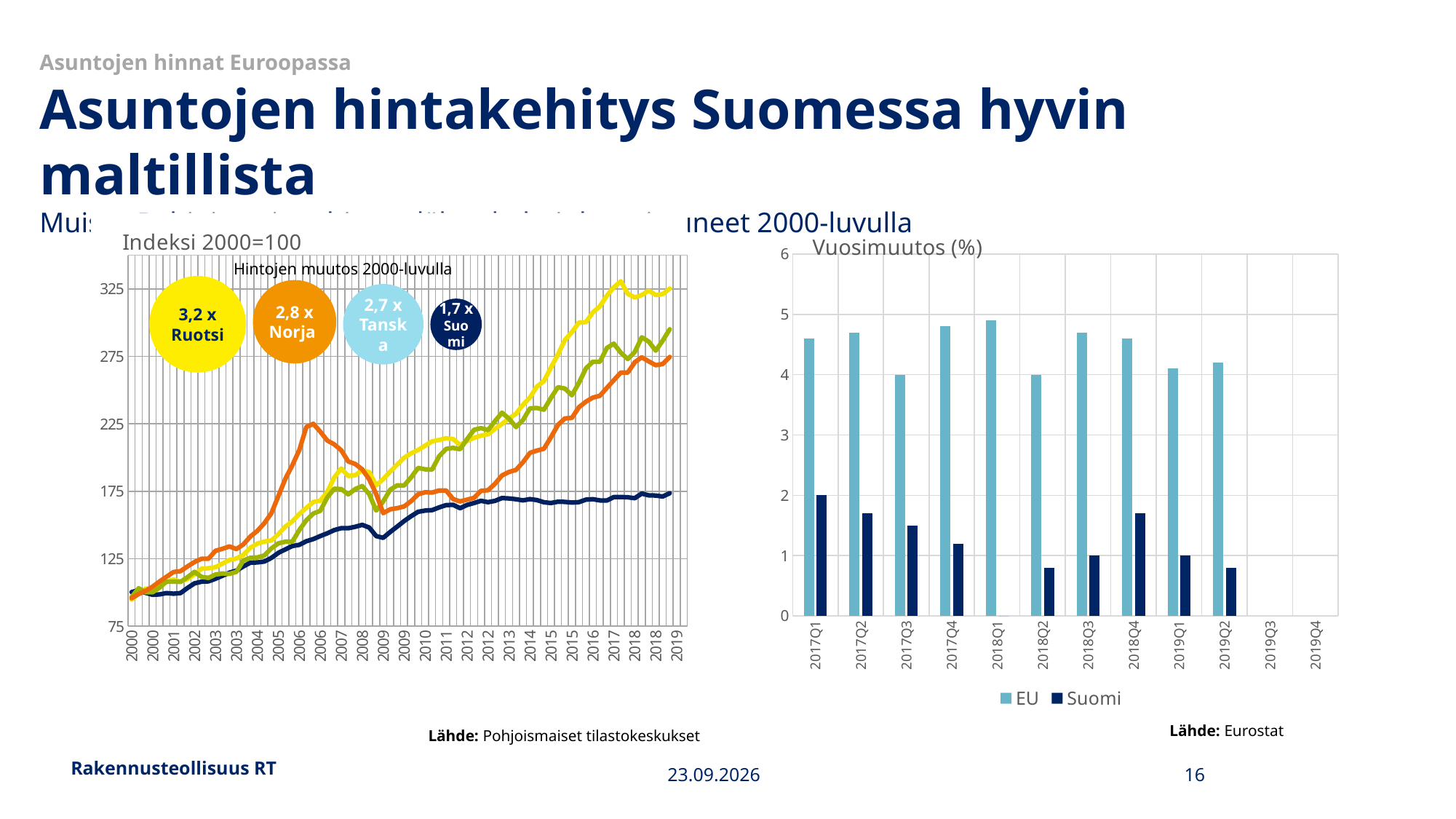
What kind of chart is the left-hand chart titled "Indeksi 2000=100"? line chart In the left-hand chart "Indeksi 2000=100", which country has the smallest price change multiplier in the 2000s? Suomi In the right-hand chart "Vuosimuutos (%)", how many quarters are labelled on the x axis? 12 In the left-hand chart "Indeksi 2000=100", what price change multiplier is shown for Ruotsi in the 2000s? 3,2 x In the right-hand chart "Vuosimuutos (%)", is the EU value for 2018Q1 greater or less than 4? greater In the right-hand chart "Vuosimuutos (%)", what are the two legend entries? EU, Suomi In the right-hand chart "Vuosimuutos (%)", in which quarter is the Suomi bar highest? 2017Q1 In the left-hand chart "Indeksi 2000=100", is the Ruotsi line in 2019 greater or less than 275? greater In the right-hand chart "Vuosimuutos (%)", is the Suomi value for 2019Q2 greater or less than 1? less In the right-hand chart "Vuosimuutos (%)", how many series does the legend list? 2 In the right-hand chart "Vuosimuutos (%)", which series has the larger value in 2017Q1, EU or Suomi? EU What kind of chart is the right-hand chart titled "Vuosimuutos (%)"? bar chart